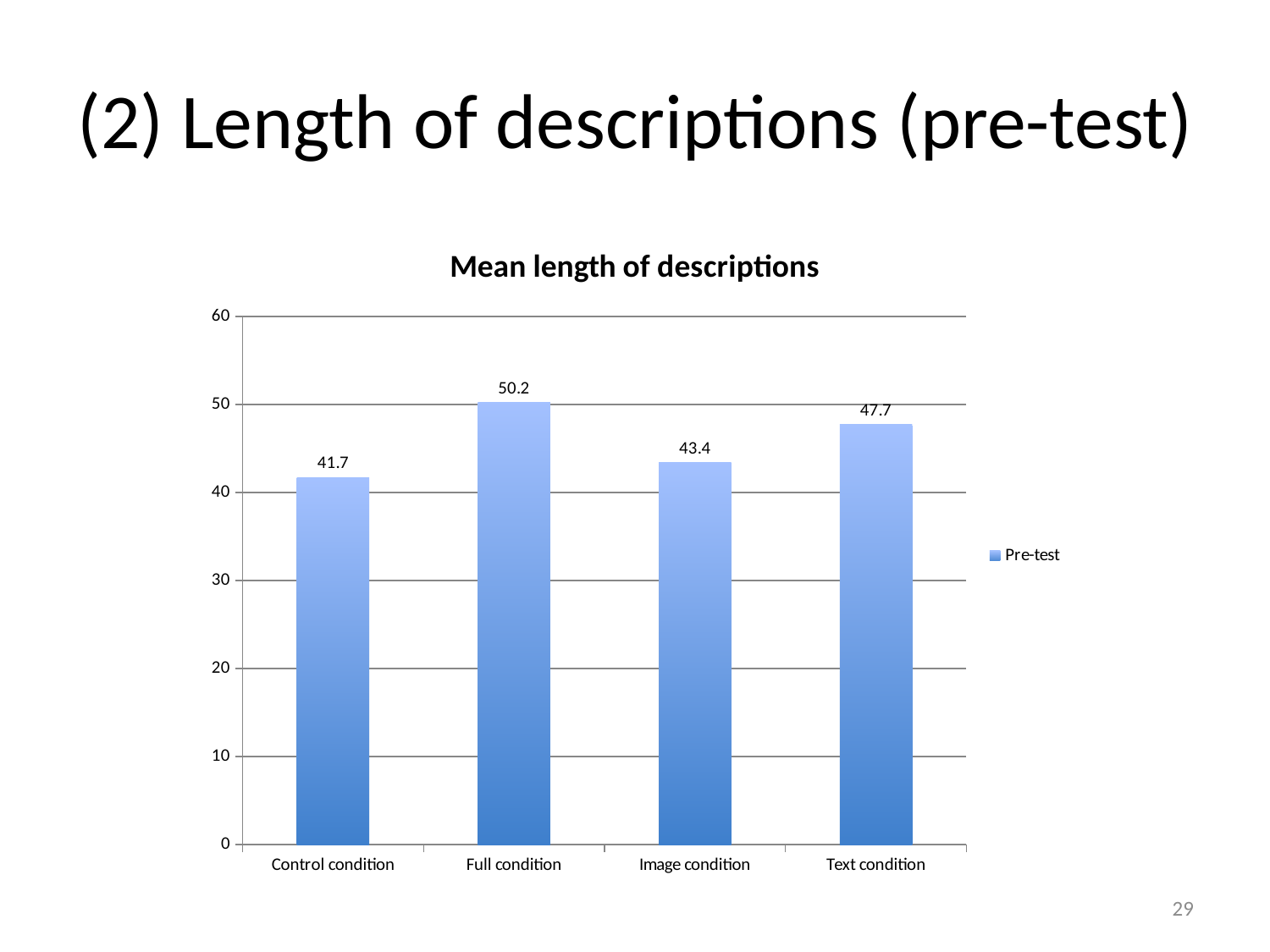
What is the mean length of descriptions for the Full condition? 50.2 What type of chart is shown on the slide? Bar chart How many series does the legend list? 1 Which condition has the highest mean length of descriptions? Full condition How many conditions are shown on the x axis? 4 What is the difference between the Full condition and the Control condition values? 8.5 Which is larger, the value for the Image condition or the Text condition? Text condition Is the value for the Full condition greater or less than 50? greater What is the value shown for the Text condition? 47.7 What is the difference between the Text condition and the Image condition values? 4.3 Which condition has the lowest mean length of descriptions? Control condition What is the mean length of descriptions for the Control condition? 41.7